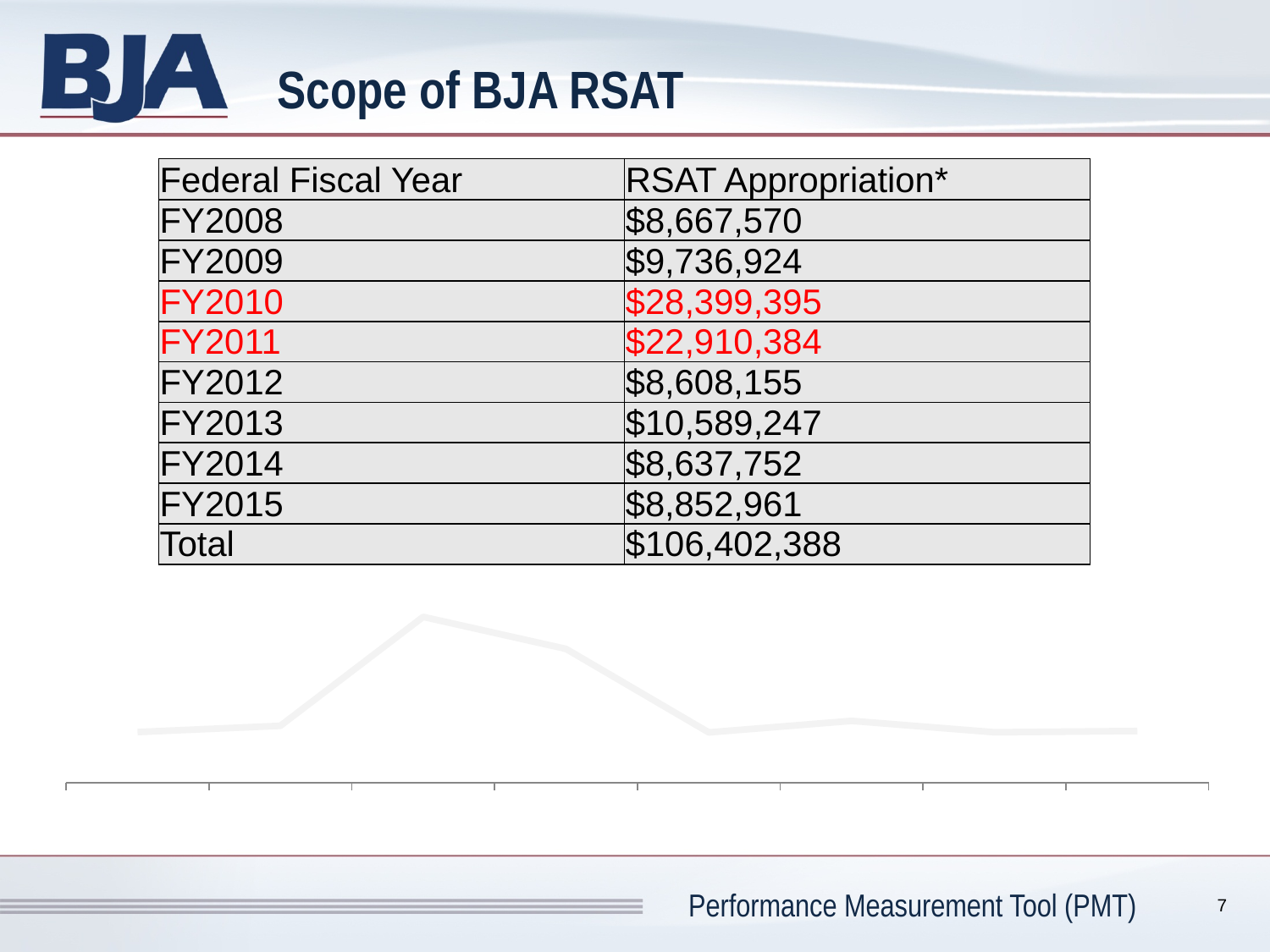
Does the line chart below the table show a legend? No In the line chart below the table, is the third point or the fourth point higher? the third point In the line chart below the table, which point is the highest? the third point In the line chart below the table, do the values rise or fall from the first point to the third point? rise How many data points does the line chart below the table have? 8 In the line chart below the table, is the fourth point or the fifth point higher? the fourth point Does the line chart below the table have a title? No What kind of chart is shown below the table on the slide? line chart In the line chart below the table, do the values rise or fall from the third point to the fifth point? fall